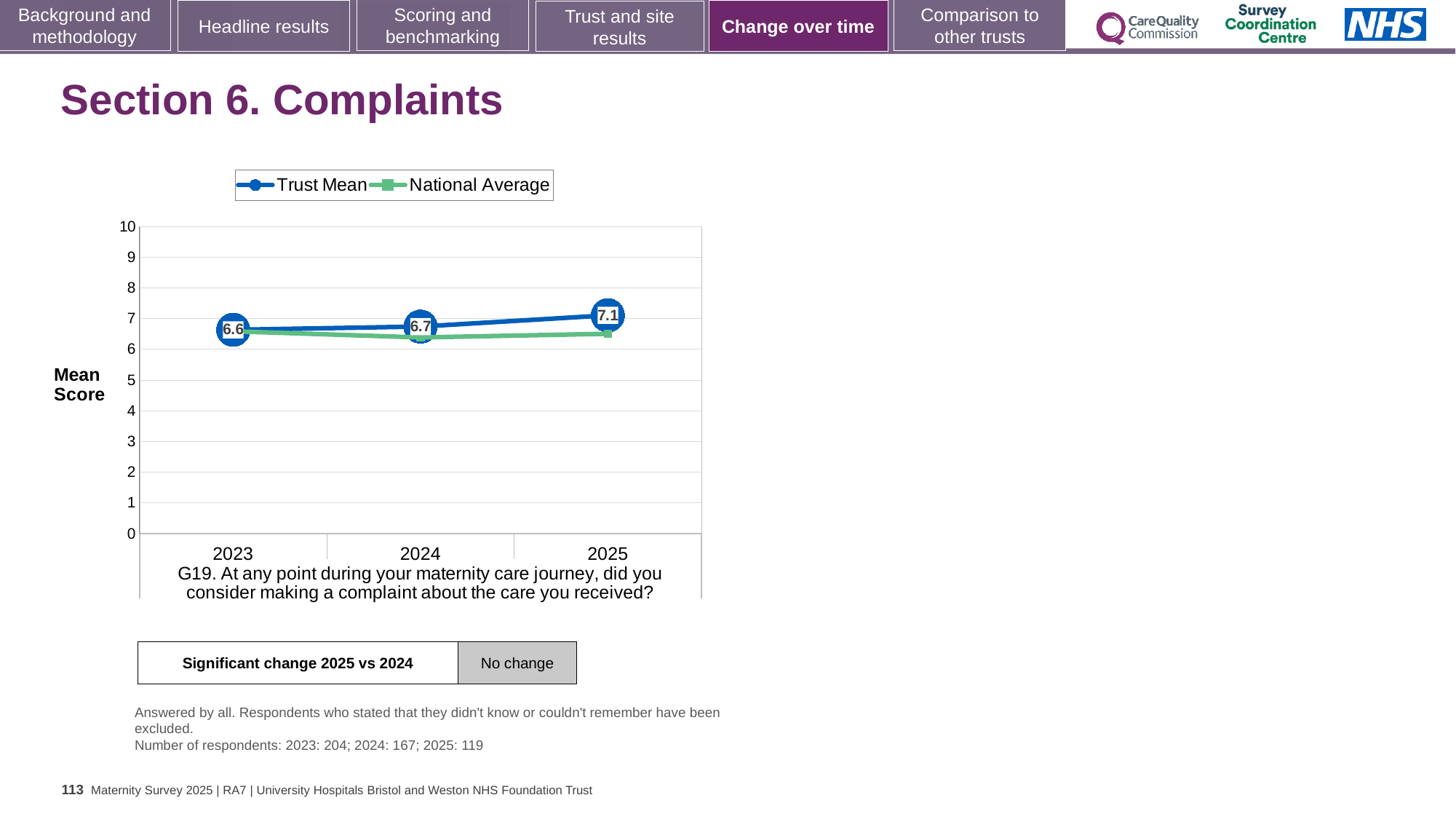
What is the Trust Mean value for 2024? 6.7 In which year is the Trust Mean highest? 2025 What kind of chart is shown on the slide? Line chart What is the Trust Mean value for 2025? 7.1 Does the Trust Mean rise or fall from 2023 to 2025? Rise Is the National Average value for 2024 greater or less than 5? greater What is the difference between the Trust Mean in 2025 and in 2023? 0.5 How many series does the legend list? 2 In which year is the Trust Mean lowest? 2023 What is the Trust Mean value for 2023? 6.6 How many years are shown on the x axis? 3 In 2025, which is larger: the Trust Mean or the National Average? Trust Mean